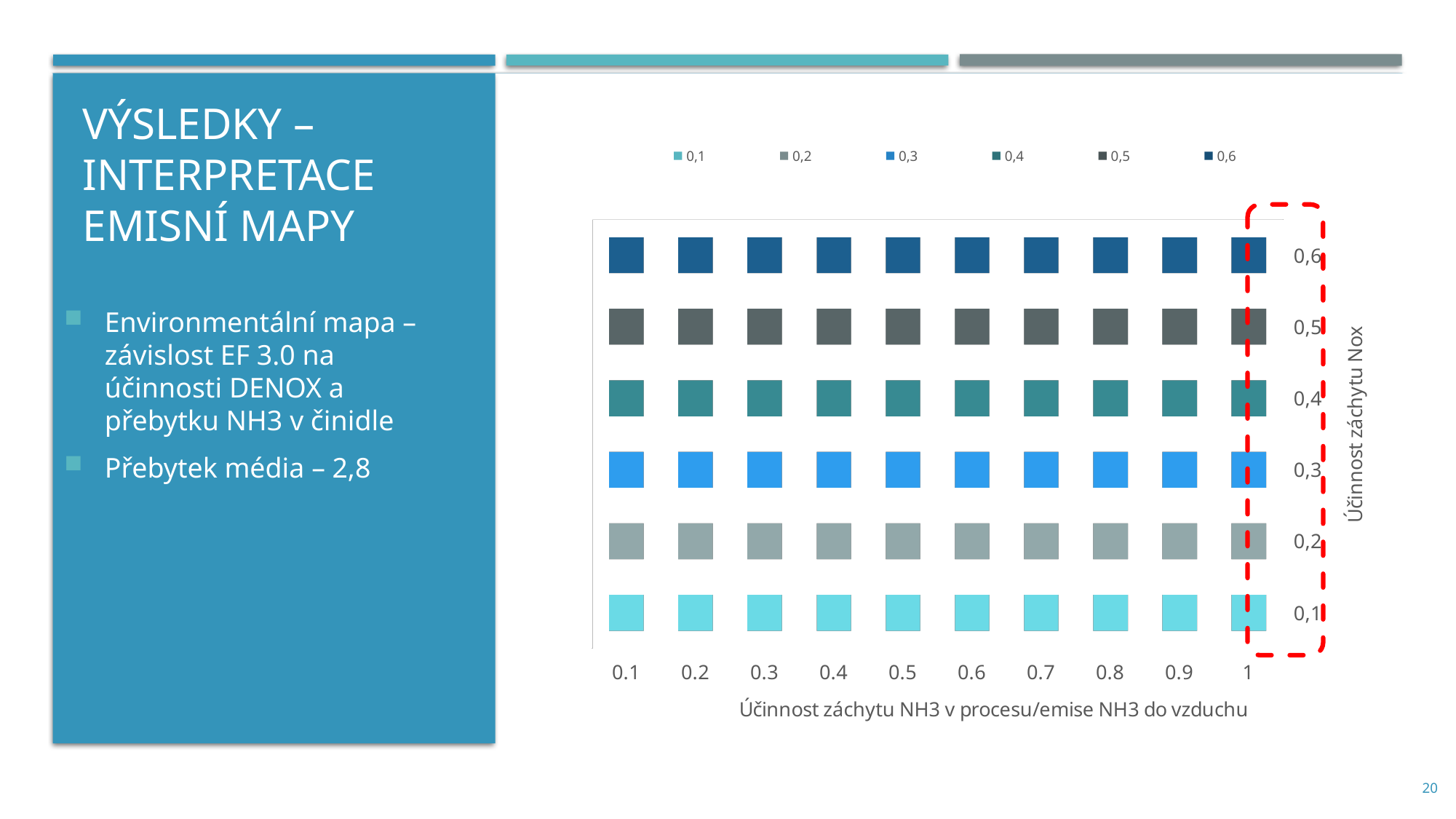
What is the last entry in the chart legend? 0,6 What is the highest value labelled on the x axis of the chart? 1 How many series does the chart legend list? 6 What is the first entry in the chart legend? 0,1 Which x-axis category is enclosed by the red dashed rectangle on the chart? 1 What is the lowest value labelled on the x axis of the chart? 0.1 What is the title of the x axis of the chart? Účinnost záchytu NH3 v procesu/emise NH3 do vzduchu How many categories are shown along the x axis of the chart? 10 How many rows of markers are plotted in the chart? 6 What is the title of the y axis of the chart? Účinnost záchytu Nox